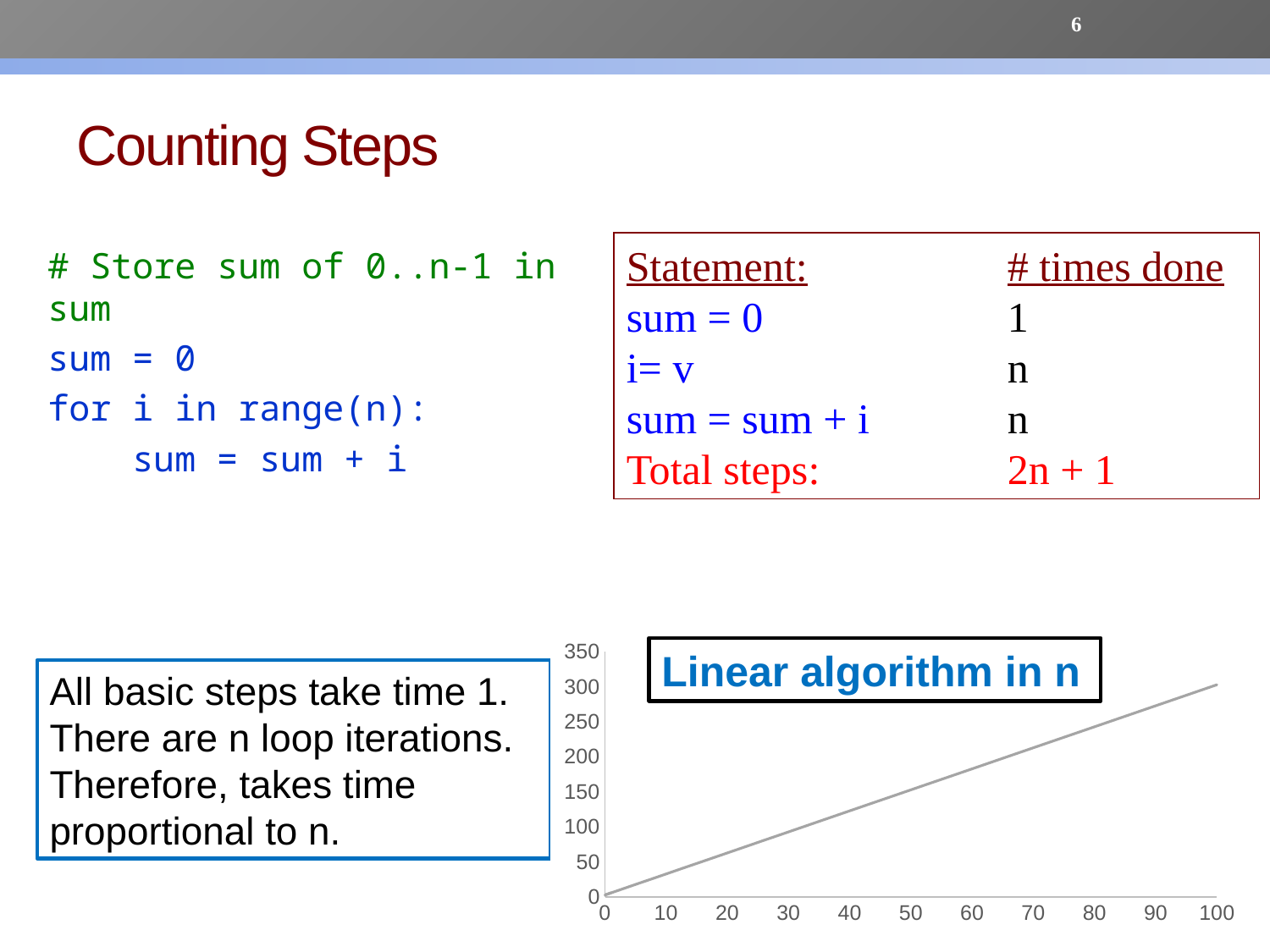
What kind of chart is shown at the bottom right of the slide? line chart Is the value of the line at x = 80 greater or less than 200? greater What text appears in the box overlaid on the chart? Linear algorithm in n Is the value of the line at x = 10 greater or less than 50? less Is the value of the line at x = 50 greater or less than 200? less What is the highest tick value shown on the chart's y axis? 350 Do the values on the chart rise or fall as x increases from 0 to 100? rise Which is larger, the value of the line at x = 30 or at x = 90? x = 90